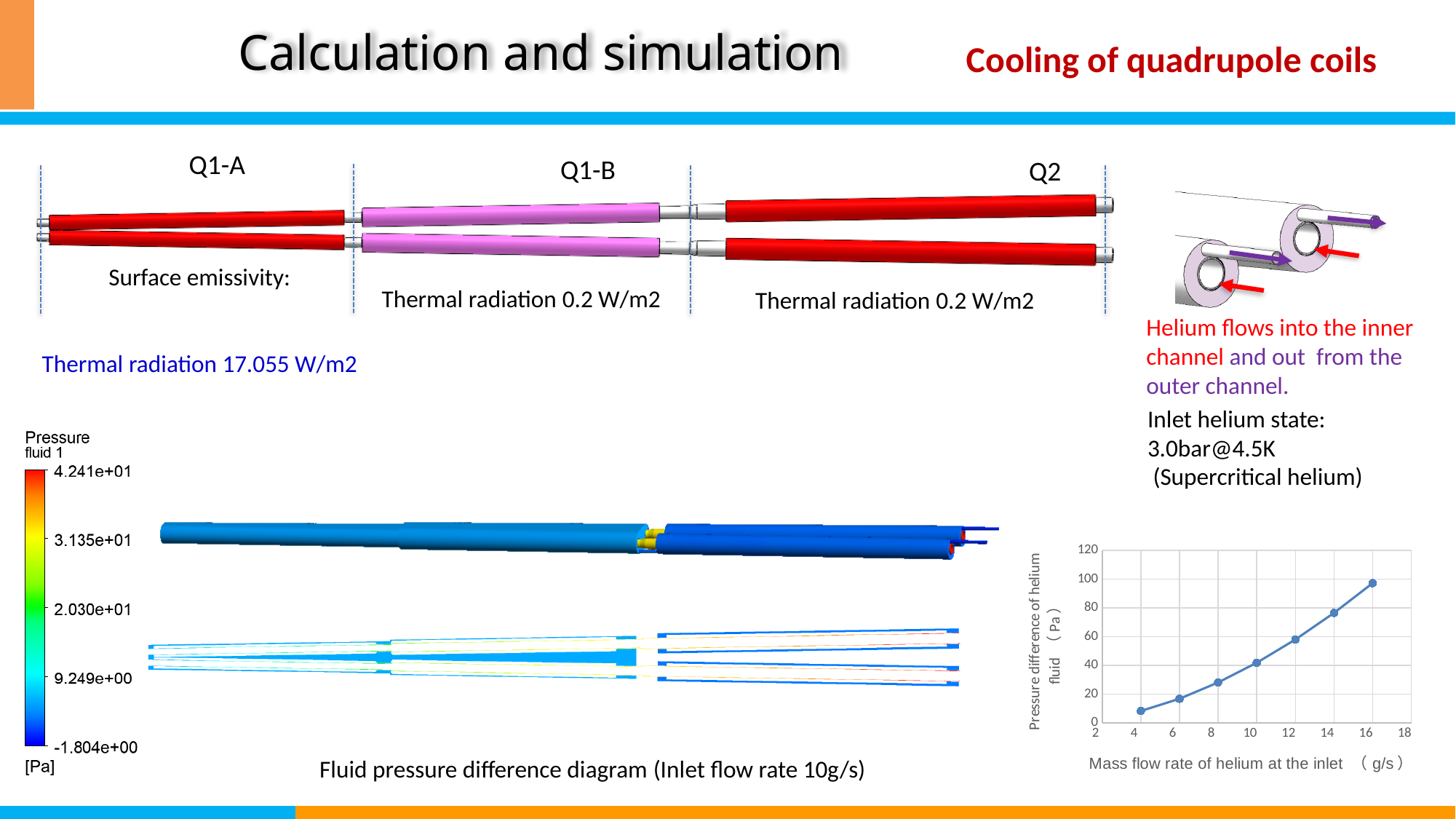
What kind of chart is shown at the bottom right of the slide? line chart In the bottom-right chart, is the pressure difference at a mass flow rate of about 8 g/s greater or less than 40 Pa? less In the bottom-right chart, is the pressure difference at the highest plotted mass flow rate (about 16 g/s) greater or less than 80 Pa? greater In the bottom-right chart, does the pressure difference rise or fall as the mass flow rate increases? rises In the bottom-right chart, what is the maximum value shown on the vertical axis? 120 In the bottom-right chart, is the pressure difference at a mass flow rate of about 10 g/s greater or less than 60 Pa? less In the bottom-right chart, how many data points are plotted on the line? 7 In the bottom-right chart, what quantity is plotted on the horizontal axis? Mass flow rate of helium at the inlet (g/s)